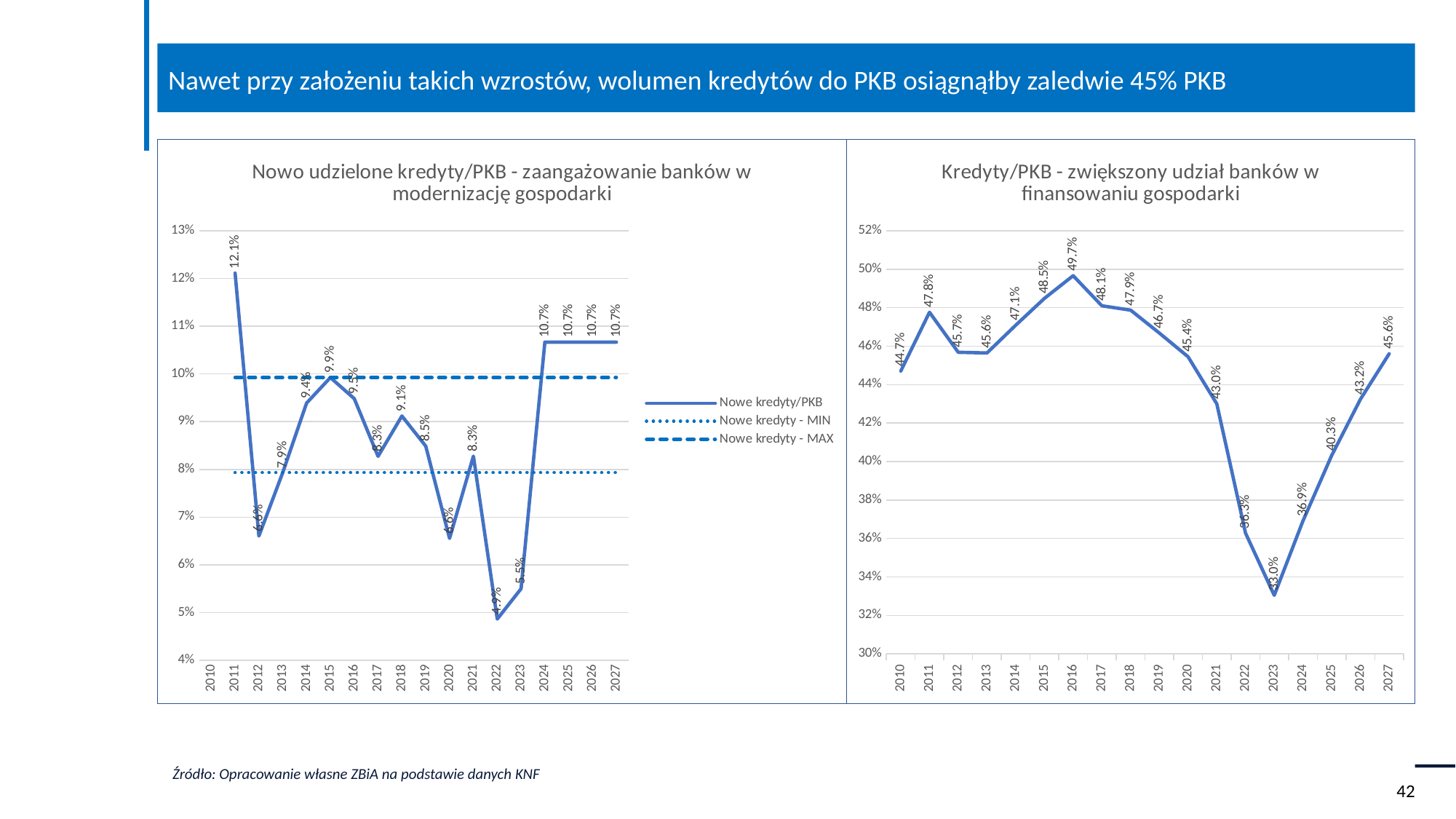
What type of chart is the right chart (Kredyty/PKB)? line chart In the left chart (Nowo udzielone kredyty/PKB), which year has the lowest value of Nowe kredyty/PKB? 2022 In the right chart (Kredyty/PKB), what is the difference between the 2016 value and the 2023 value? 16.7 percentage points In the left chart (Nowo udzielone kredyty/PKB), what is the value shown for 2027? 10.7% In the left chart (Nowo udzielone kredyty/PKB), how many series does the legend list? 3 In the right chart (Kredyty/PKB), do the values rise or fall from 2023 to 2027? rise In the right chart (Kredyty/PKB), which year has the lowest value? 2023 In the right chart (Kredyty/PKB), which is larger: the value for 2011 or the value for 2027? 2011 In the left chart (Nowo udzielone kredyty/PKB), what is the difference between the 2015 value and the 2022 value? 5.0 percentage points In the left chart (Nowo udzielone kredyty/PKB), what is the value for 2011? 12.1% In the right chart (Kredyty/PKB), which year has the highest value? 2016 In the right chart (Kredyty/PKB), what is the value for 2016? 49.7%